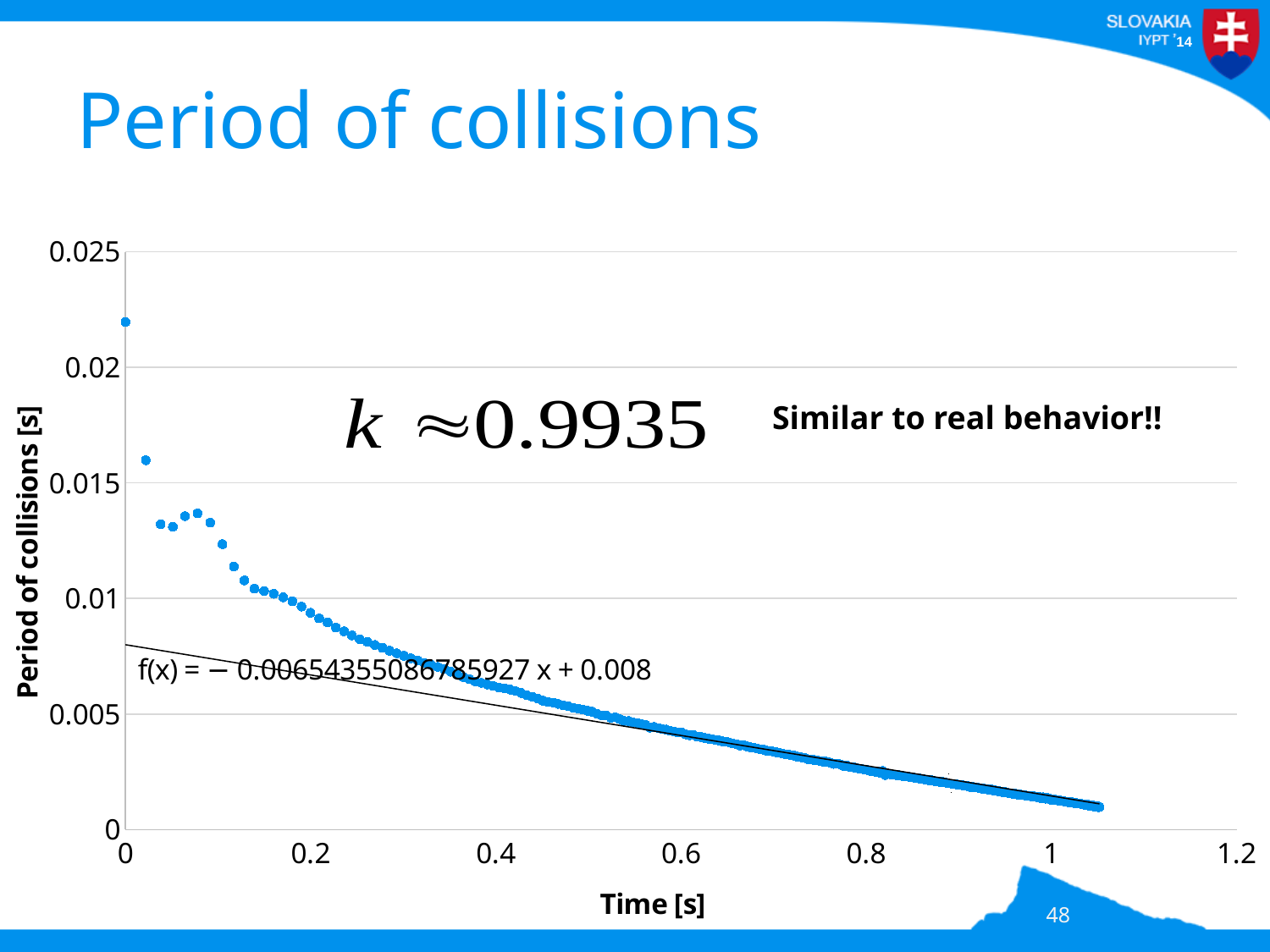
Is the period of collisions at time 0.6 s greater or less than 0.005? less What kind of chart is shown on the slide? scatter chart What is the label of the y axis? Period of collisions [s] What is the slope of the fitted line f(x) shown on the chart? −0.00654355086785927 At which time is the plotted period of collisions highest? 0 Is the period of collisions at time 1 s greater or less than 0.005? less What is the intercept of the fitted line f(x) shown on the chart? 0.008 Is the period of collisions at time 0.2 s greater or less than 0.005? greater What is the label of the x axis? Time [s] Do the plotted period values generally rise or fall as time increases along the x axis? fall Which is larger, the period of collisions at time 0.2 s or at time 0.8 s? at time 0.2 s